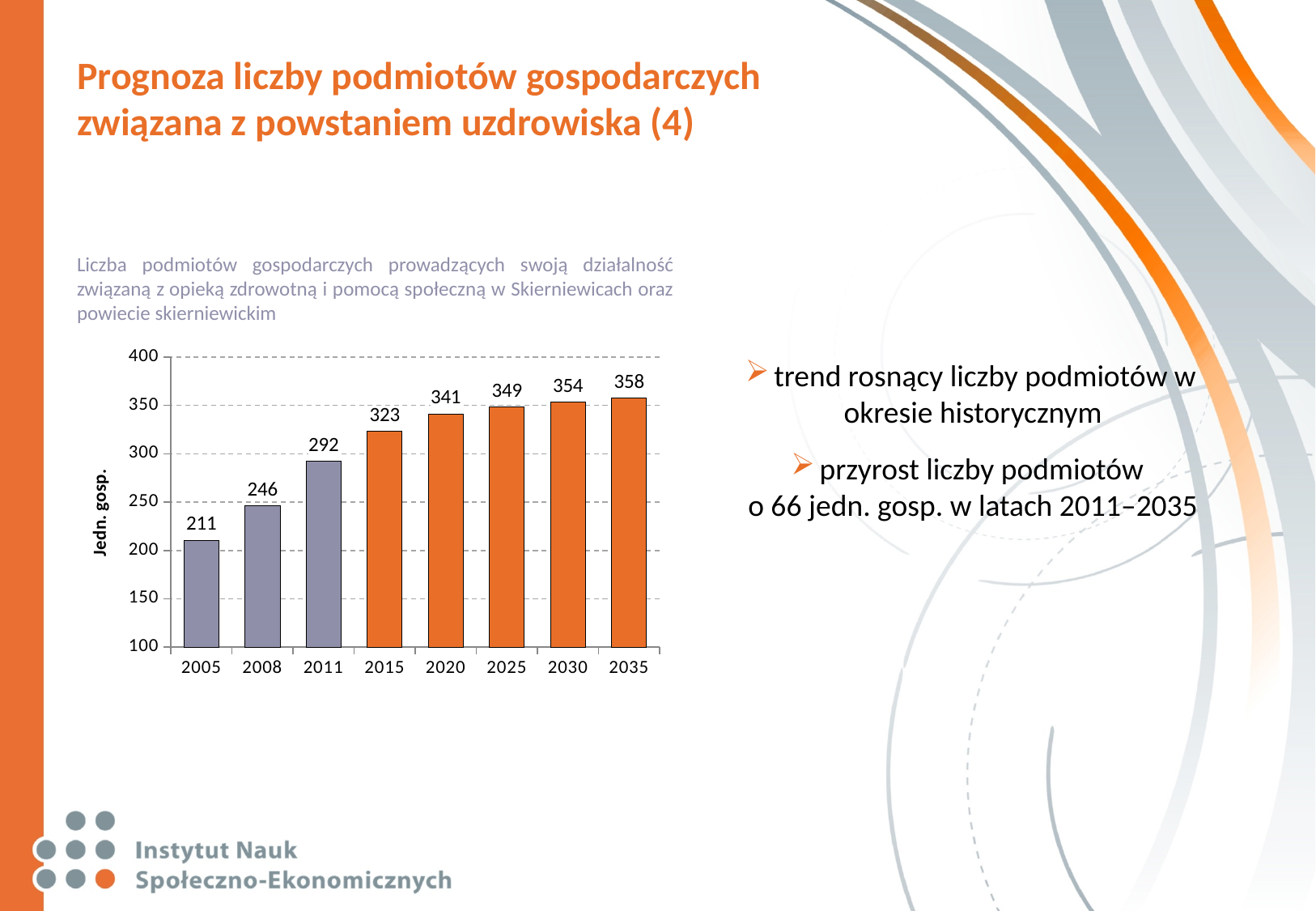
What is the value for 2035 in the chart? 358 Do the values rise or fall from 2005 to 2035? rise What is the value for 2011 in the chart? 292 What is the difference between the values for 2015 and 2008? 77 What is the difference between the values for 2035 and 2011? 66 Which year has the lowest value in the chart? 2005 What kind of chart is shown on the slide? bar chart Is the value for 2008 greater or less than 250? less Which is larger, the value for 2020 or the value for 2011? 2020 What is the value for 2005 in the chart? 211 Which year has the highest value in the chart? 2035 How many years are shown on the x axis of the chart? 8